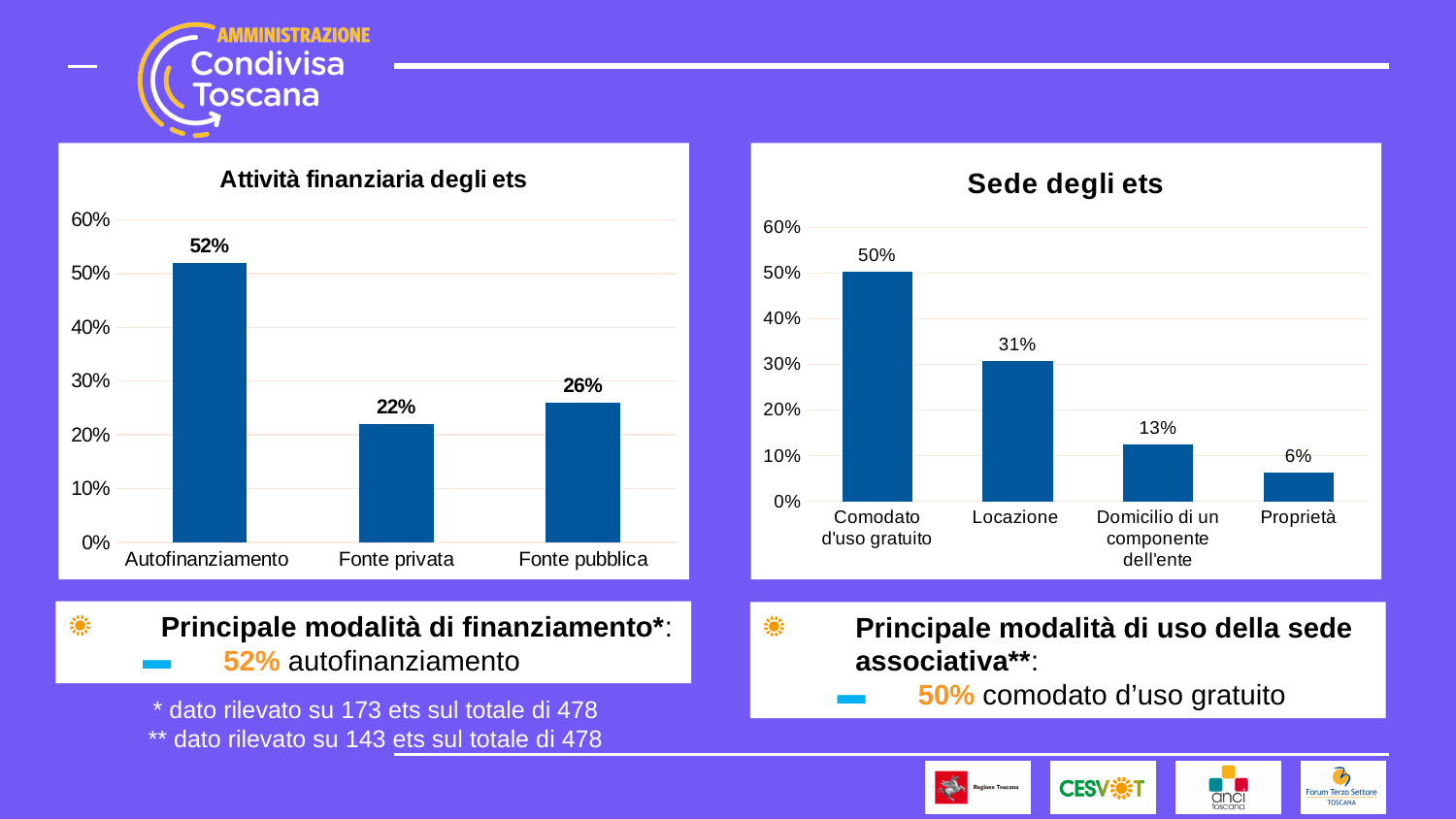
In the 'Sede degli ets' chart, do the values rise or fall from left to right along the x axis? fall In the 'Attività finanziaria degli ets' chart, what is the difference between Autofinanziamento and Fonte pubblica? 26% In the 'Attività finanziaria degli ets' chart, what is the value for Autofinanziamento? 52% In the 'Attività finanziaria degli ets' chart, which category has the lowest value? Fonte privata In the 'Sede degli ets' chart, which category has the highest value? Comodato d'uso gratuito In the 'Sede degli ets' chart, what is the value for Locazione? 31% In the 'Sede degli ets' chart, what is the difference between Comodato d'uso gratuito and Locazione? 19% In the 'Sede degli ets' chart, what is the value for Proprietà? 6% What kind of chart is the 'Sede degli ets' chart? bar chart In the 'Attività finanziaria degli ets' chart, what is the value for Fonte privata? 22% In the 'Sede degli ets' chart, which is larger: Locazione or Domicilio di un componente dell'ente? Locazione In the 'Attività finanziaria degli ets' chart, how many categories are shown? 3